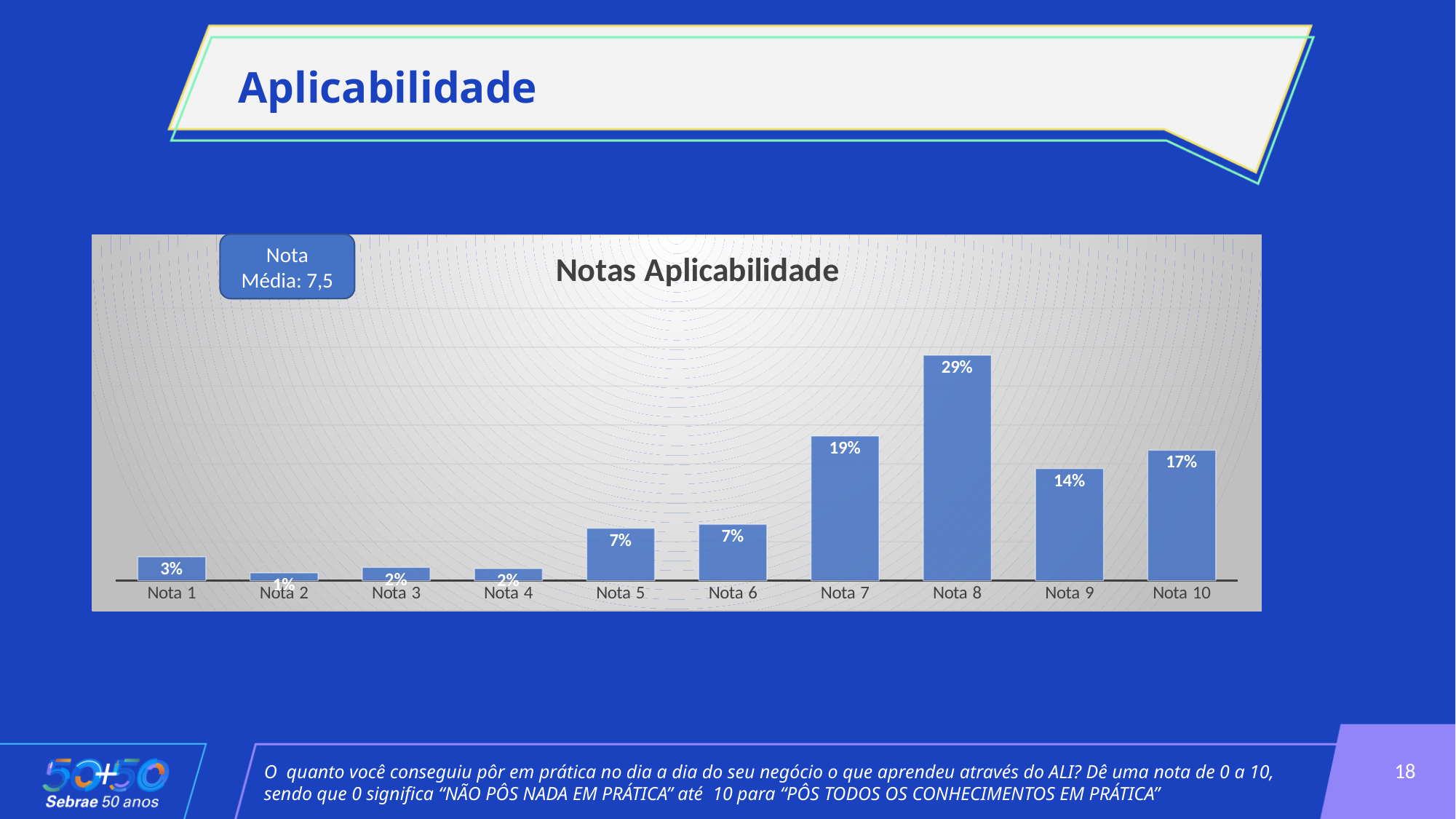
What is the difference between the values for Nota 8 and Nota 9? 15% What is the difference between the values for Nota 10 and Nota 7? 2% What is the value for Nota 8? 29% How many categories are shown on the x axis? 10 Which is larger, the value for Nota 9 or the value for Nota 10? Nota 10 Which category has the highest value? Nota 8 Which category has the lowest value? Nota 2 What is the value for Nota 10? 17% What is the title of the chart? Notas Aplicabilidade What is the value for Nota 7? 19% What kind of chart is shown? Bar chart What is the value for Nota 1? 3%